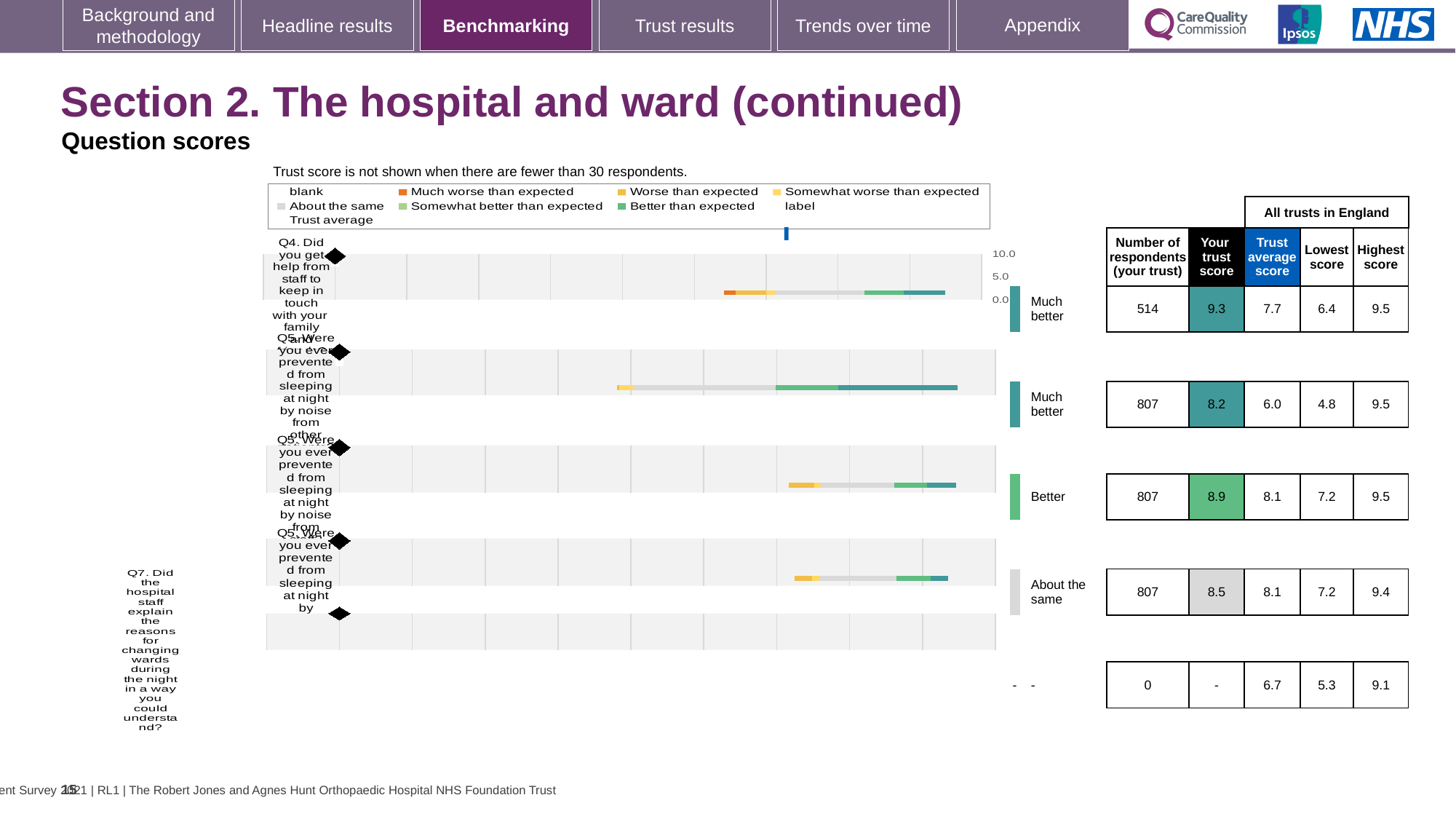
In the second row of the table, which is larger: 'Your trust score' or the 'Trust average score'? Your trust score (8.2) How many respondents are shown for the last row of the table? 0 What is 'Your trust score' for the first row (Q4) in the table? 9.3 Which row of the table has the highest 'Your trust score'? The first row (Q4), 9.3 By how much does 'Your trust score' exceed the 'Trust average score' in the first row (Q4)? 1.6 What benchmark category label is given for the second row of the chart? Much better What is the 'Lowest score' across all trusts in England for the second row of the table? 4.8 How many question rows are shown in the chart and table? 5 What kind of chart is used to show the question scores on this slide? bar chart What is the 'Trust average score' for the first row (Q4)? 7.7 What is the maximum value shown on the chart's score axis? 10.0 How many respondents from your trust are shown for the first row (Q4, keeping in touch with family and friends)? 514